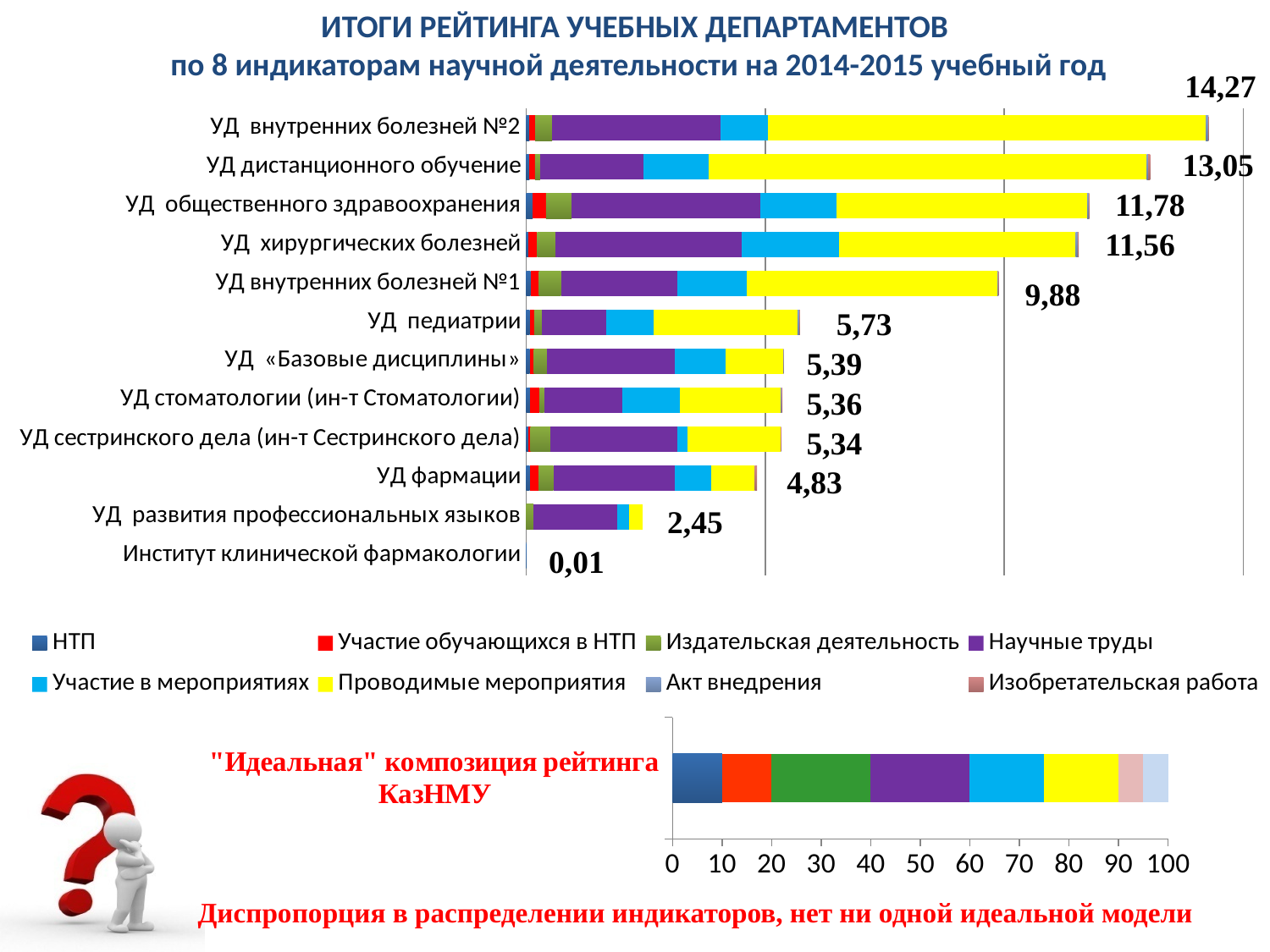
In the bottom chart ("Идеальная" композиция рейтинга КазНМУ), what is the maximum value shown on the horizontal axis? 100 In the top chart, what is the difference between the totals for УД внутренних болезней №2 and УД дистанционного обучение? 1,22 In the top chart, what is the difference between the totals for УД внутренних болезней №1 and УД фармации? 5,05 In the top chart, which department has the highest total value? УД внутренних болезней №2 How many departments (categories) are shown in the top chart? 12 In the top chart, what is the total value labeled for УД фармации? 4,83 In the top chart, which department has the lowest total value? Институт клинической фармакологии In the top chart (rating results of educational departments), what is the total value labeled for УД внутренних болезней №2? 14,27 In the top chart, which has the larger total: УД хирургических болезней or УД развития профессиональных языков? УД хирургических болезней What type of chart is the top chart? Stacked bar chart In the top chart, what is the total value labeled for УД педиатрии? 5,73 How many series does the legend of the top chart list? 8